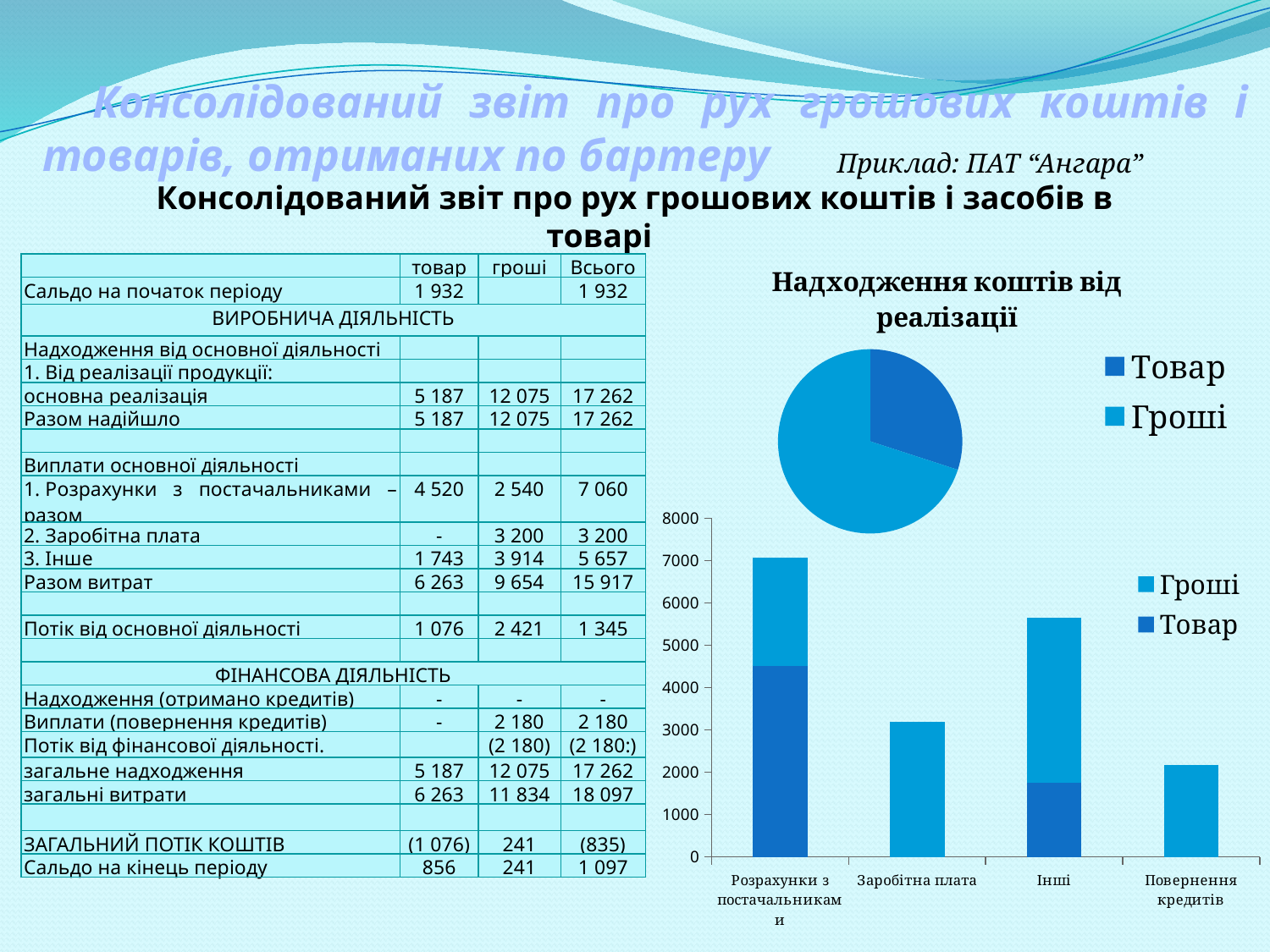
In the pie chart "Надходження коштів від реалізації", which slice is larger: Товар or Гроші? Гроші In the bar chart at the bottom right, which category has the shortest stacked bar? Повернення кредитів What is the title of the pie chart on the slide? Надходження коштів від реалізації In the bar chart at the bottom right, which stacked bar is taller: Інші or Заробітна плата? Інші In the bar chart at the bottom right, how many series does the legend list? 2 In the bar chart at the bottom right, is the total value for Повернення кредитів greater or less than 3000? less In the bar chart at the bottom right, which category has the tallest stacked bar? Розрахунки з постачальниками In the bar chart at the bottom right, is the total value for Заробітна плата greater or less than 4000? less What kind of chart is the chart titled "Надходження коштів від реалізації"? pie chart In the bar chart at the bottom right, how many categories are shown on the x axis? 4 What kind of chart is the chart at the bottom right of the slide? bar chart In the bar chart at the bottom right, is the total value for Розрахунки з постачальниками greater or less than 6000? greater